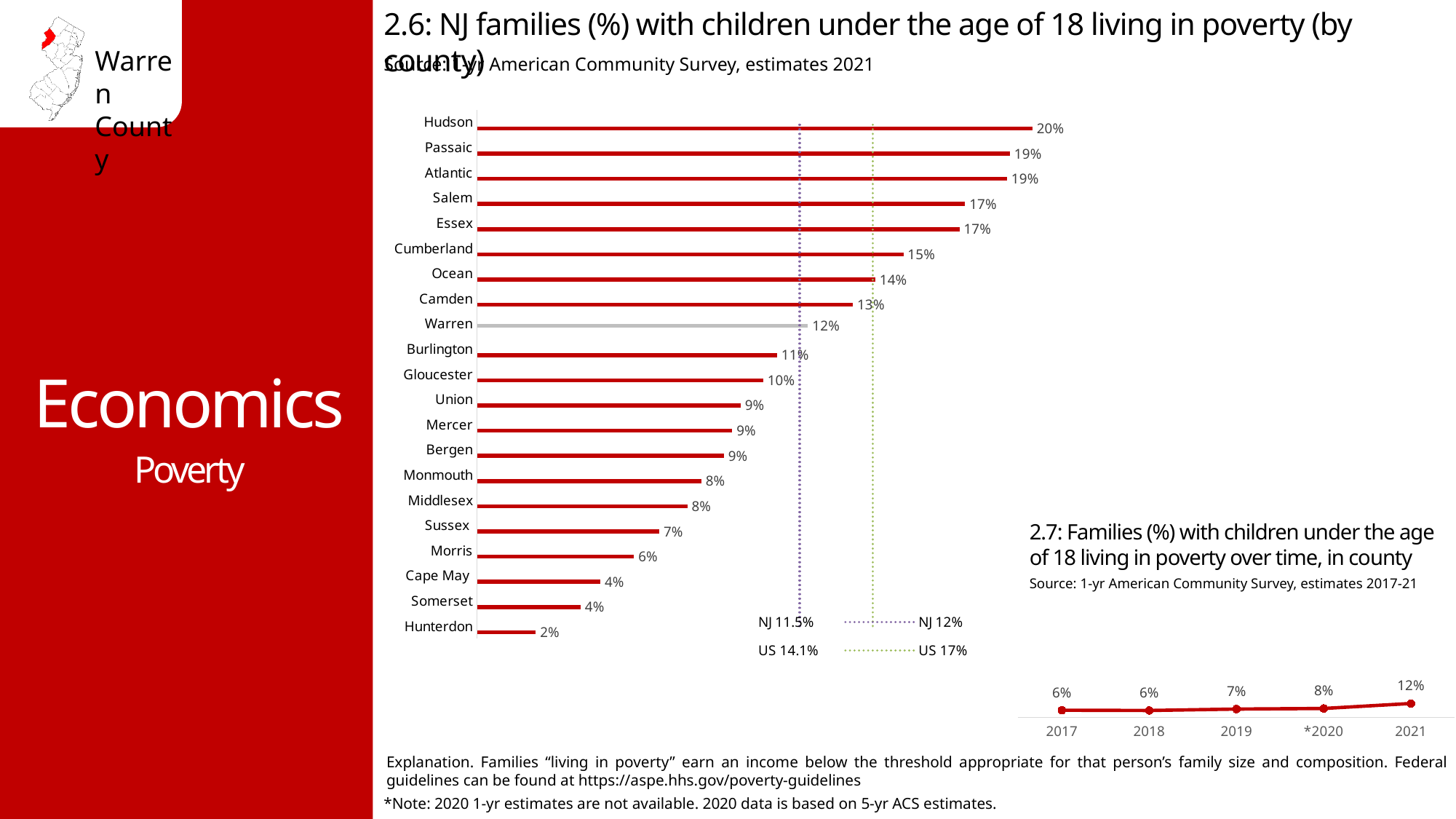
In chart 2.7, do the values rise or fall from 2017 to 2021? Rise What kind of chart is chart 2.6? Bar chart In chart 2.6, which county has the lowest value? Hunterdon In chart 2.7, what is the difference between the values for 2021 and 2017? 6% In chart 2.7, how many years are plotted? 5 In chart 2.6, what is the value for Warren? 12% In chart 2.6, how many counties are plotted? 21 In chart 2.6, what is the value for Ocean? 14% In chart 2.6, which is larger, the value for Cumberland or the value for Camden? Cumberland In chart 2.6, which county has the highest value? Hudson In chart 2.7, what is the value for 2021? 12% In chart 2.6, what is the difference between the values for Hudson and Hunterdon? 18%